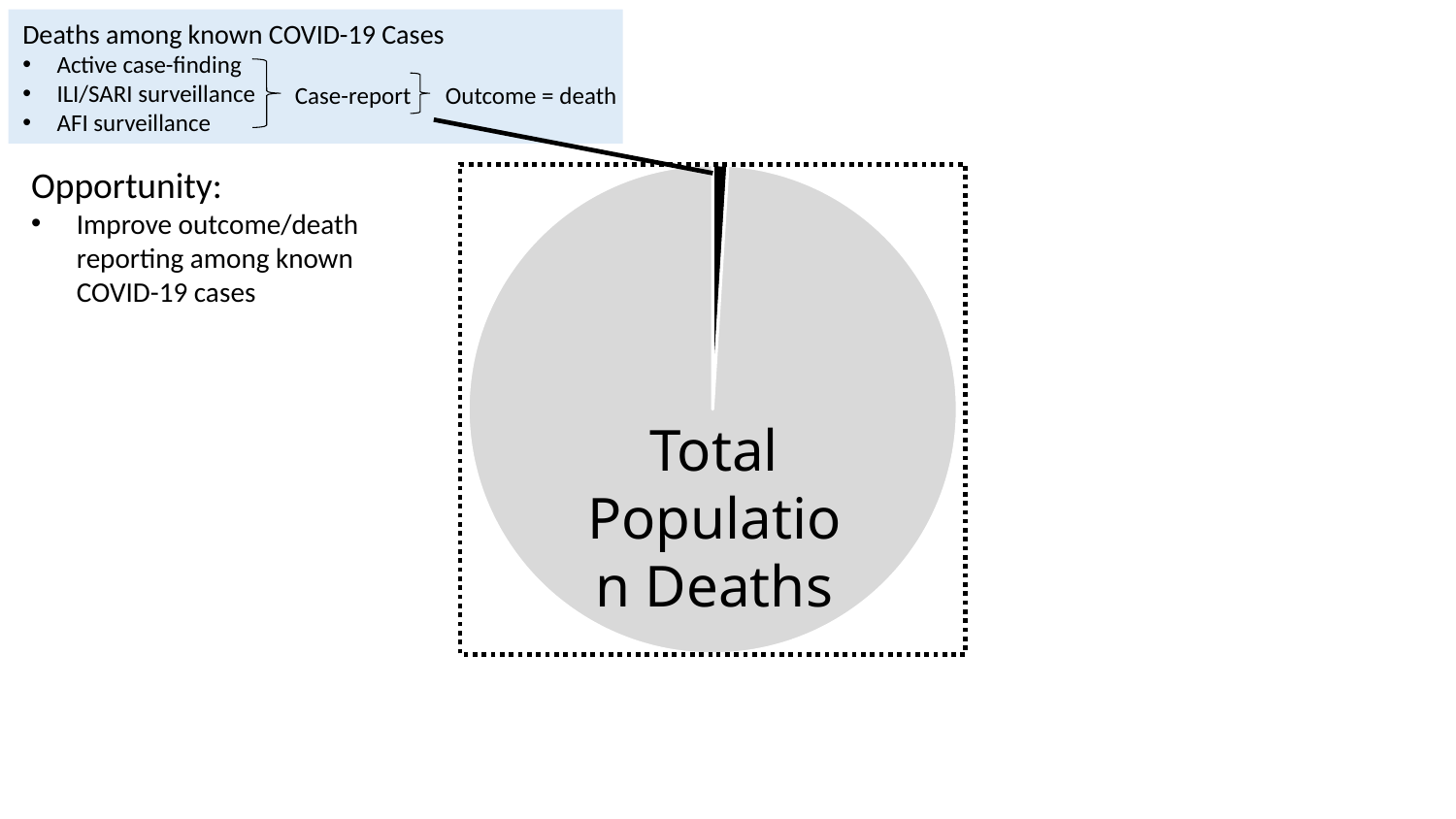
What label is printed on the large grey slice of the pie chart? Total Population Deaths How many slices does the pie chart have? 2 What colour is the large slice of the pie chart? grey Which slice of the pie chart is the largest? Total Population Deaths Is the slice for Total Population Deaths larger or smaller than the black slice? larger What kind of chart is shown on the slide? pie chart Does the pie chart show a legend? No